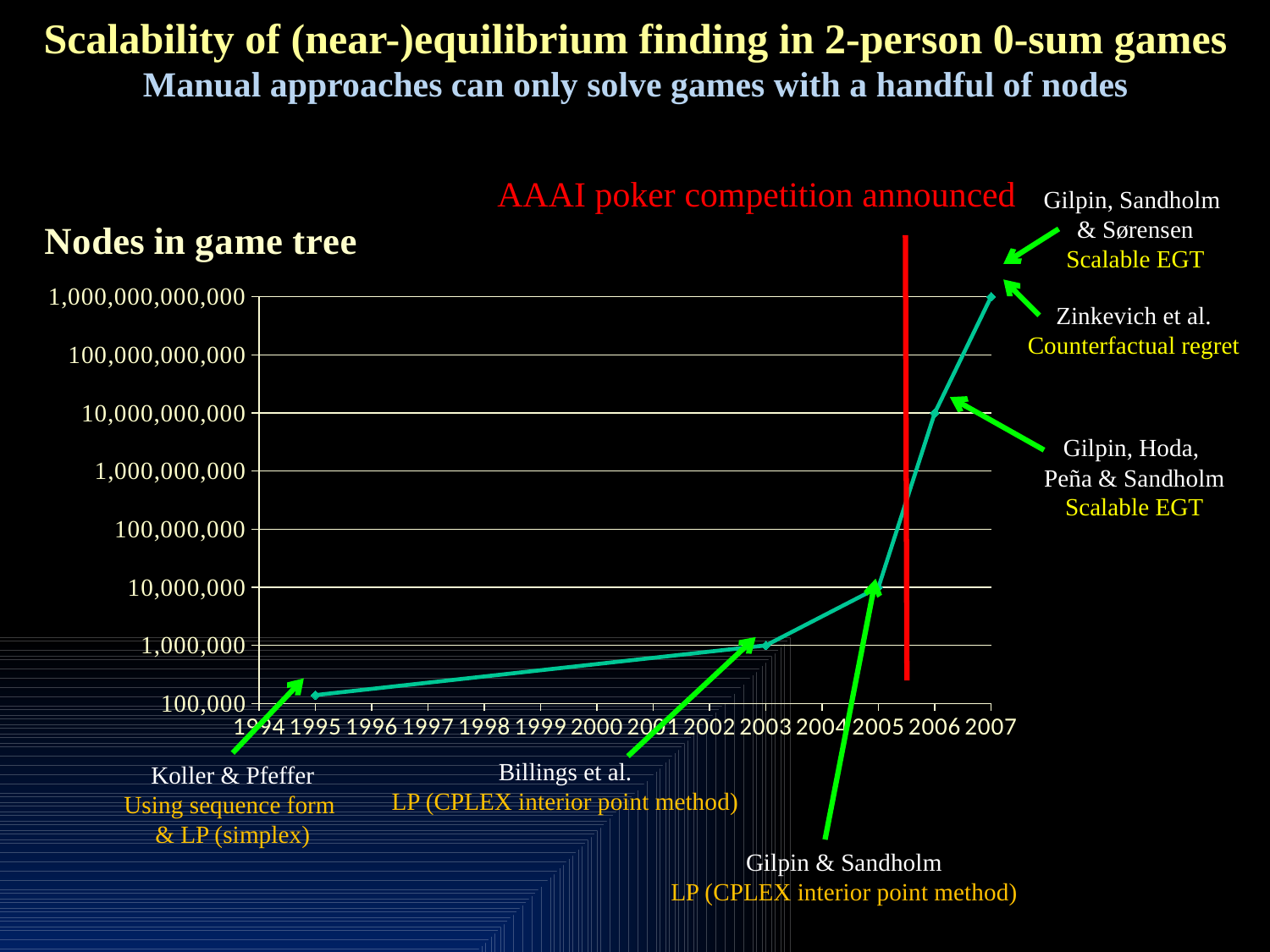
How many data points are plotted on the line? 5 Which year has the lowest number of nodes in the game tree? 1995 What kind of chart is shown on the slide? line chart Which year has the highest number of nodes in the game tree? 2007 Is the value for 2007 greater or less than 100,000,000,000? greater Is the value for 2005 greater or less than 1,000,000? greater Which year has a larger value, 2006 or 2003? 2006 Is the value for 1995 greater or less than 1,000,000? less What is the label of the y axis of the chart? Nodes in game tree What event does the red vertical line in the chart mark? AAAI poker competition announced Do the values in the chart rise or fall as the years increase along the x axis? rise